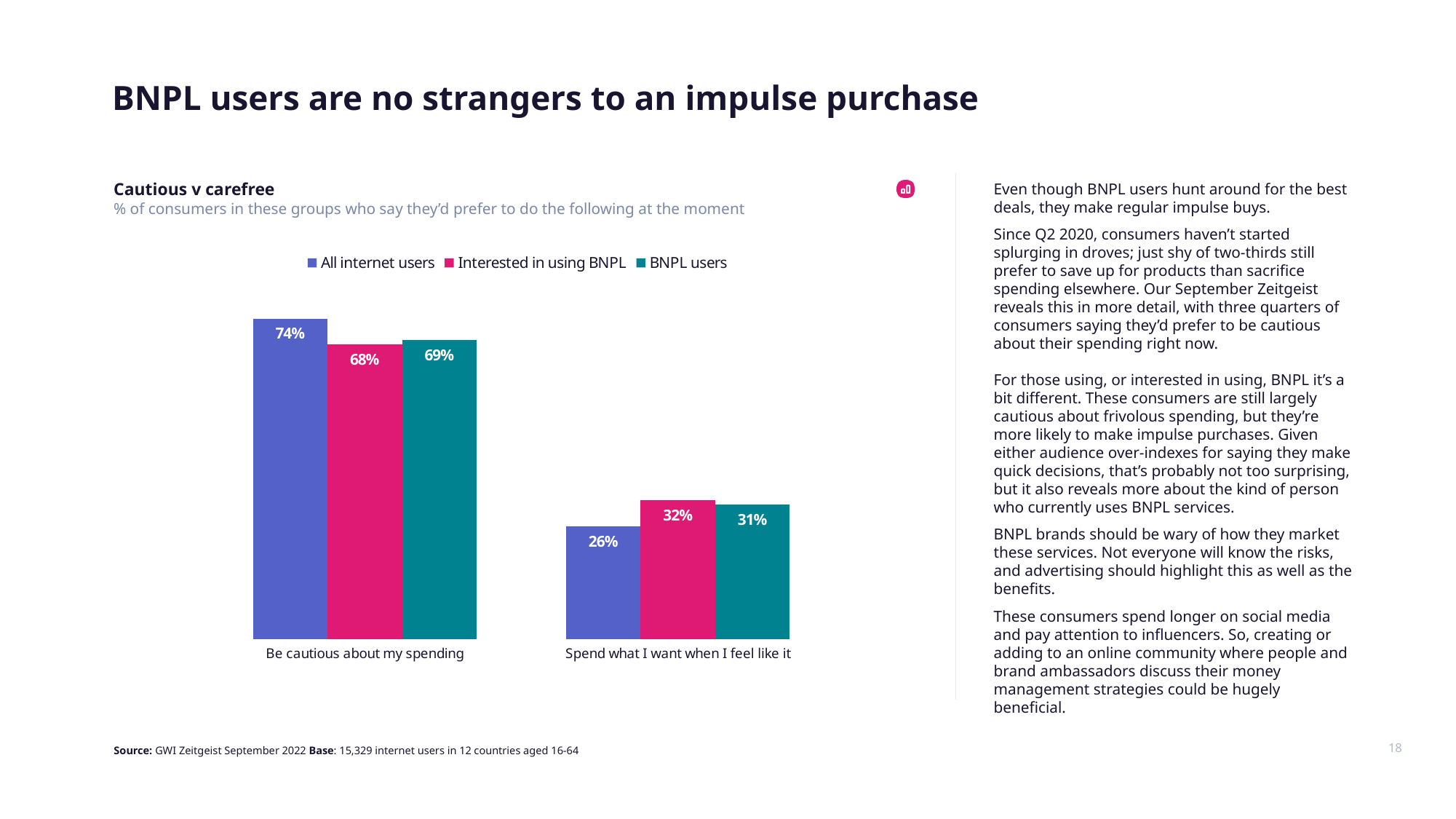
What is the difference between all internet users and those interested in using BNPL for 'Be cautious about my spending'? 6 percentage points Which group has the highest value for 'Be cautious about my spending'? All internet users What percentage of all internet users say they'd prefer to be cautious about their spending? 74% How many categories are shown on the x axis? 2 What is the difference between all internet users and BNPL users for 'Spend what I want when I feel like it'? 5 percentage points What is the value for 'Interested in using BNPL' in the 'Be cautious about my spending' category? 68% Which group has the lowest value for 'Spend what I want when I feel like it'? All internet users How many series does the legend list? 3 What percentage of BNPL users say they'd prefer to spend what they want when they feel like it? 31% What is the title of the chart? Cautious v carefree Which is larger: the value for 'Interested in using BNPL' or 'BNPL users' in the 'Spend what I want when I feel like it' category? Interested in using BNPL What kind of chart is shown on the slide? Bar chart